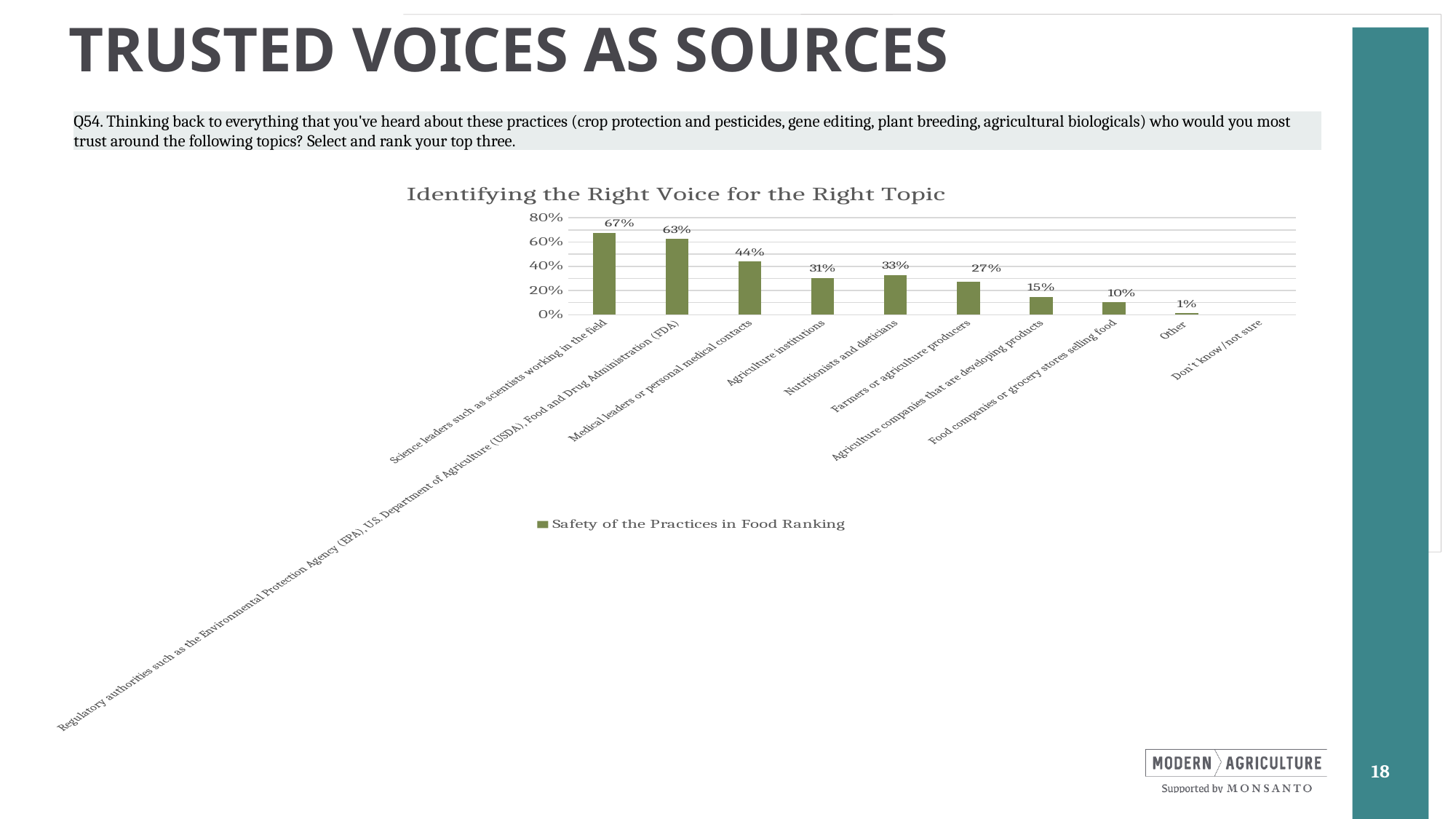
What kind of chart is shown on the slide? bar chart What is the difference between the values for Agriculture companies that are developing products and Food companies or grocery stores selling food? 5% What is the value for Science leaders such as scientists working in the field? 67% What series name does the legend show? Safety of the Practices in Food Ranking What is the value for Medical leaders or personal medical contacts? 44% What is the value for Nutritionists and dieticians? 33% Which is larger, the value for Agriculture institutions or the value for Farmers or agriculture producers? Agriculture institutions What is the value for Food companies or grocery stores selling food? 10% What is the difference between the values for Science leaders such as scientists working in the field and Regulatory authorities such as the EPA, USDA, FDA? 4% Which category has the highest value? Science leaders such as scientists working in the field Is the value for Medical leaders or personal medical contacts greater or less than 40%? greater How many categories are shown on the x axis? 10